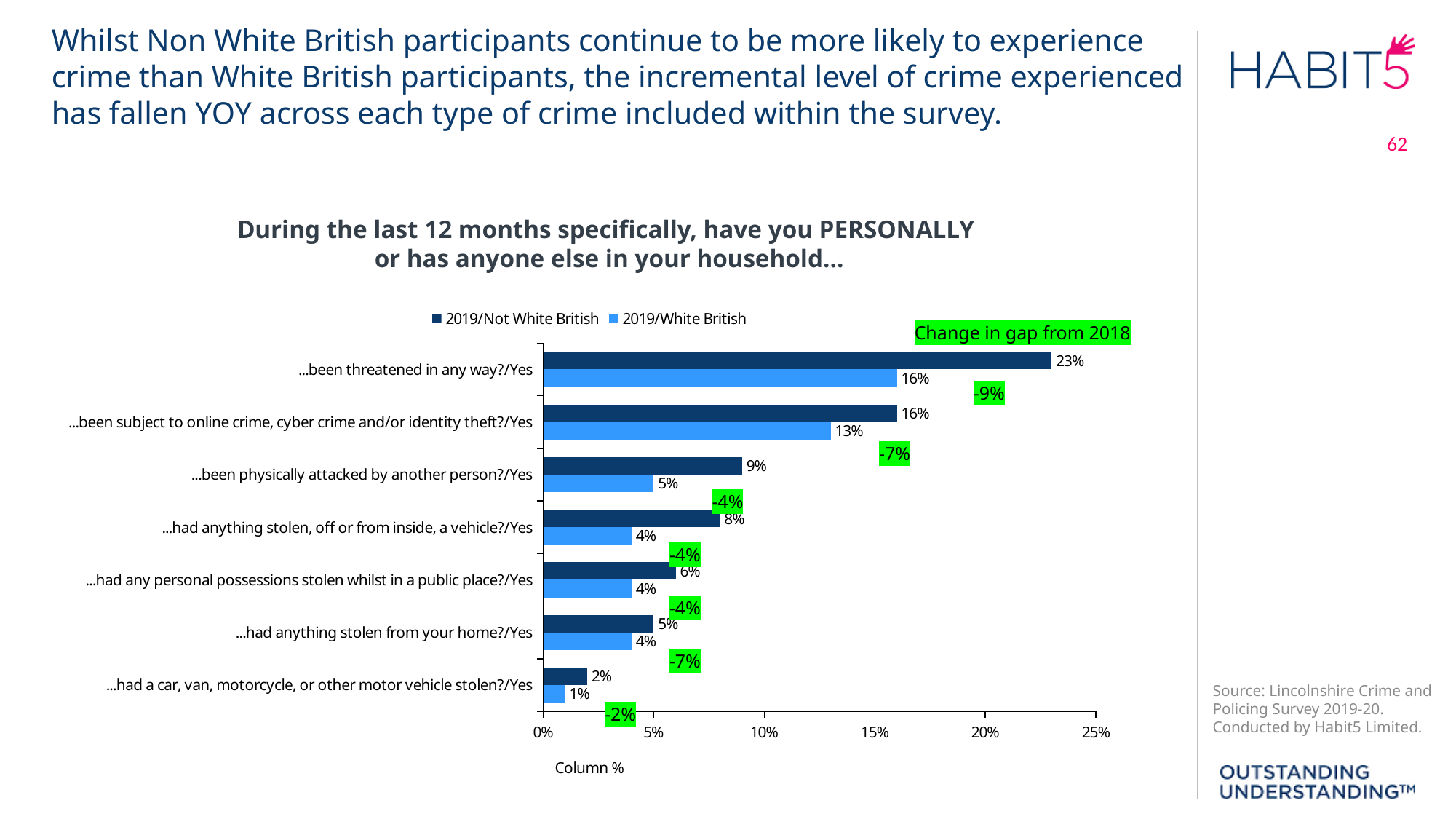
Which crime type has the highest value for 2019/Not White British participants? ...been threatened in any way?/Yes Which crime type has the lowest value for 2019/White British participants? ...had a car, van, motorcycle, or other motor vehicle stolen?/Yes How many series does the legend list? 2 What kind of chart is shown on the slide? Bar chart What is the 'Change in gap from 2018' shown for having been threatened in any way? -9% What is the value for 2019/White British participants who had been physically attacked by another person? 5% What is the label on the horizontal axis of the chart? Column % For having anything stolen off or from inside a vehicle, which series has the larger value: 2019/Not White British or 2019/White British? 2019/Not White British What is the difference between the 2019/Not White British and 2019/White British values for having been threatened in any way? 7% What percentage of 2019/White British participants said they had been subject to online crime, cyber crime and/or identity theft? 13% What percentage of 2019/Not White British participants said they had been threatened in any way? 23% How many crime types are listed on the chart? 7